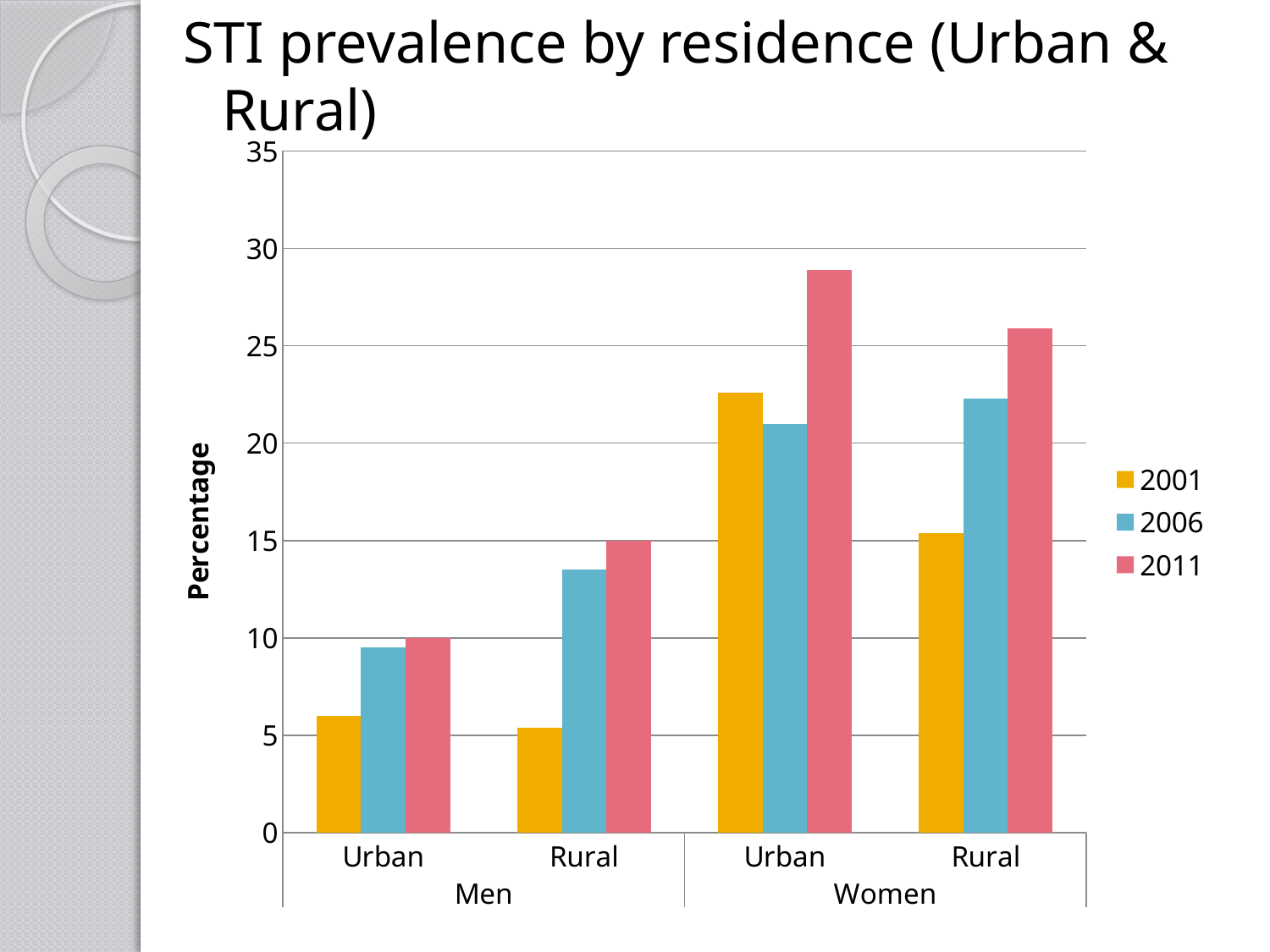
Which years are listed in the legend? 2001, 2006, 2011 How many residence categories (bar groups) are shown along the x axis? 4 How many series does the legend list? 3 Is the value for Men Rural in 2006 greater or less than 10? greater What is the label on the vertical axis? Percentage For Women Urban, which year has the larger value, 2001 or 2006? 2001 What kind of chart is shown on the slide? bar chart Is the value for Women Rural in 2006 greater or less than 20? greater Is the value for Women Urban in 2011 greater or less than 25? greater For Men Rural, do the values rise or fall from 2001 to 2011? rise Which group and year has the highest bar in the chart? Women Urban, 2011